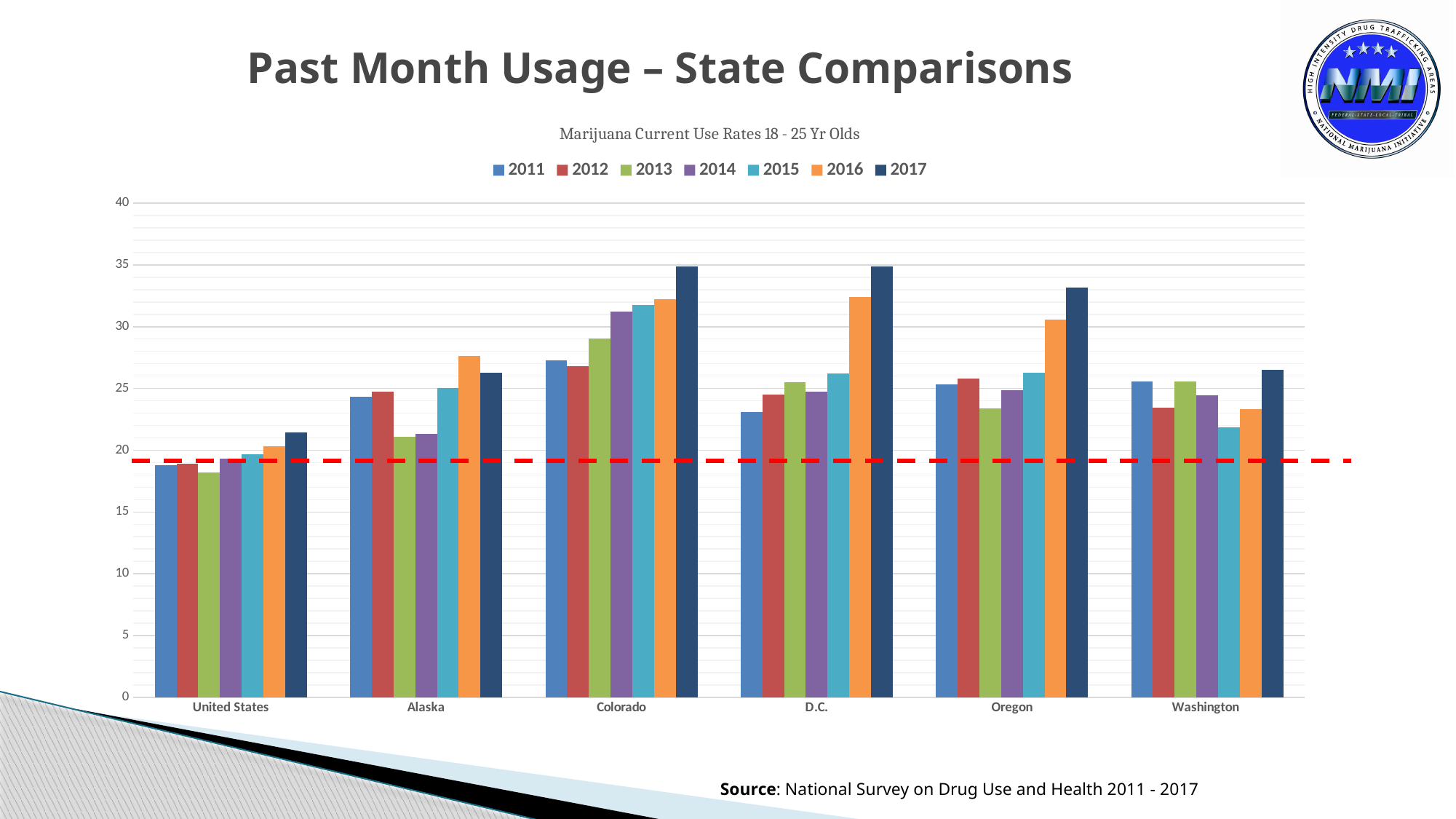
What is the title of the chart? Marijuana Current Use Rates 18 - 25 Yr Olds For Oregon, which is larger: the 2015 value or the 2016 value? 2016 How many series does the legend list? 7 Is the 2013 value for United States greater or less than 20? less Is the 2017 value for Colorado greater or less than 30? greater Within Alaska, which year has the highest bar? 2016 For Colorado, do the bars generally rise or fall from 2011 to 2017? rise Which category has the lowest 2011 bar? United States How many states/categories are shown along the x axis? 6 Within Washington, which year has the lowest bar? 2015 Is the 2016 value for D.C. greater or less than 30? greater What kind of chart is shown on the slide? bar chart